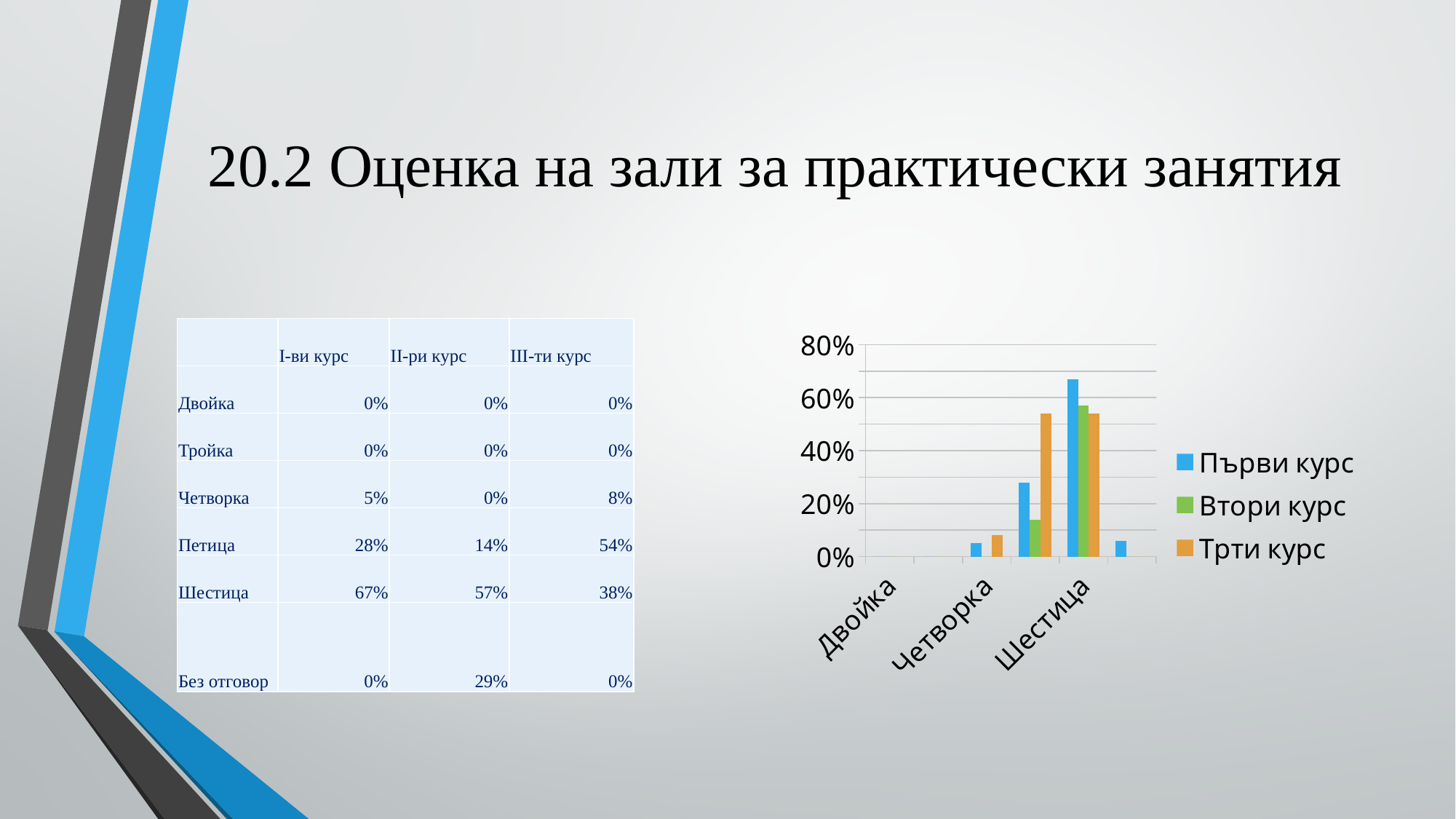
Which series has the tallest bar at Шестица? Първи курс Is the value for Първи курс at Четворка greater or less than 20%? less Which category has the tallest bar for Първи курс? Шестица Is the value for Първи курс at Шестица greater or less than 60%? greater Is the value for Втори курс at Шестица greater or less than 40%? greater What kind of chart is shown on the right of the slide? bar chart Which series is shown in orange in the chart? Трти курс Which series has the tallest bar in the whole chart? Първи курс What is the highest value shown on the chart's vertical axis? 80% At Шестица, which is larger: Първи курс or Втори курс? Първи курс How many series does the chart legend list? 3